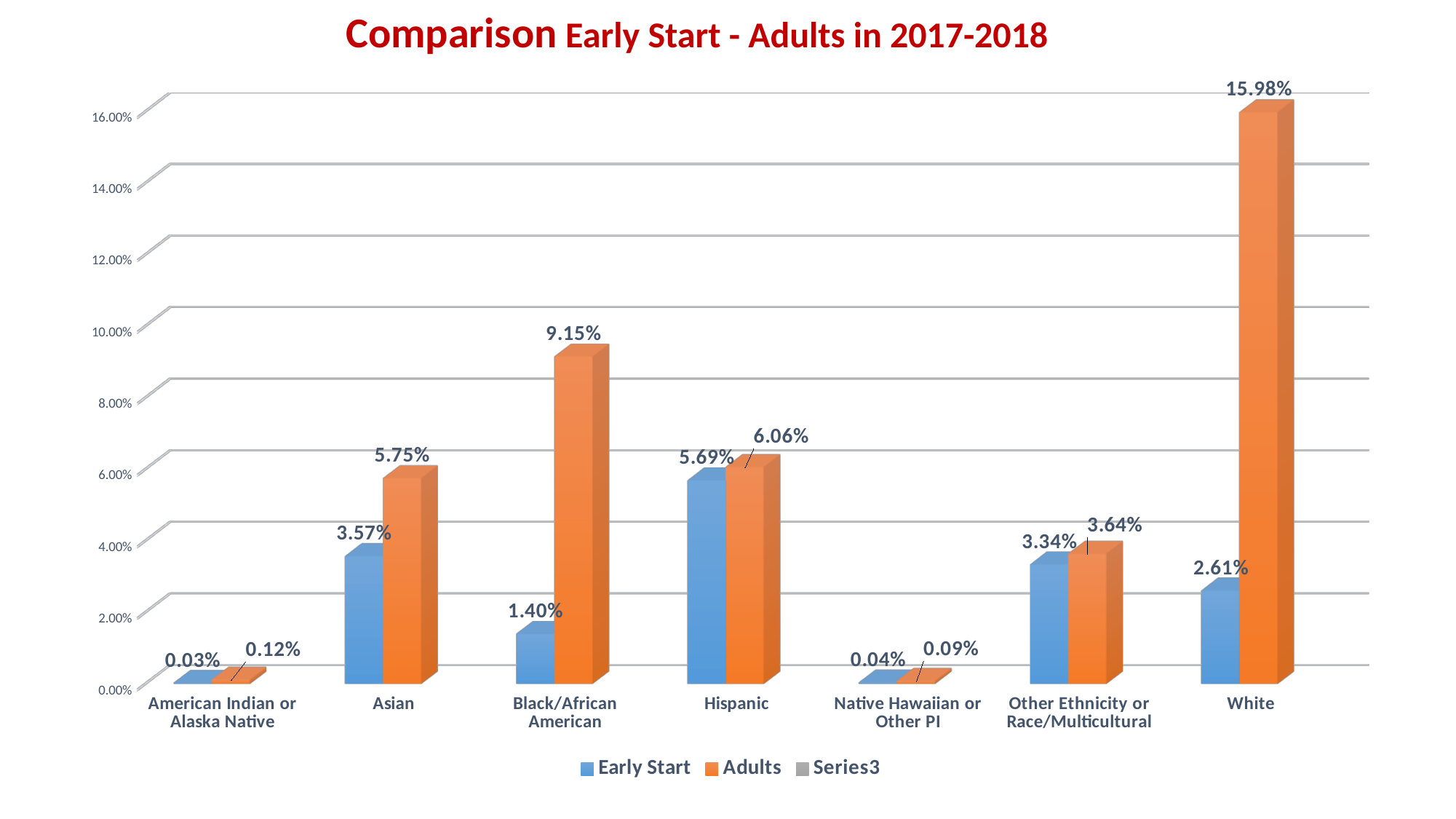
What is the Adults value for Native Hawaiian or Other PI? 0.09% How many categories are shown on the x axis? 7 Which is larger for Asian: the Early Start value or the Adults value? Adults What is the Early Start value for Hispanic? 5.69% What is the difference between the Adults and Early Start values for White? 13.37% Which category has the highest Adults value? White Which category has the lowest Early Start value? American Indian or Alaska Native How many series does the legend list? 3 What is the Adults value for White? 15.98% What colour represents the Adults series? Orange What is the Early Start value for Black/African American? 1.40% What kind of chart is shown on the slide? Bar chart